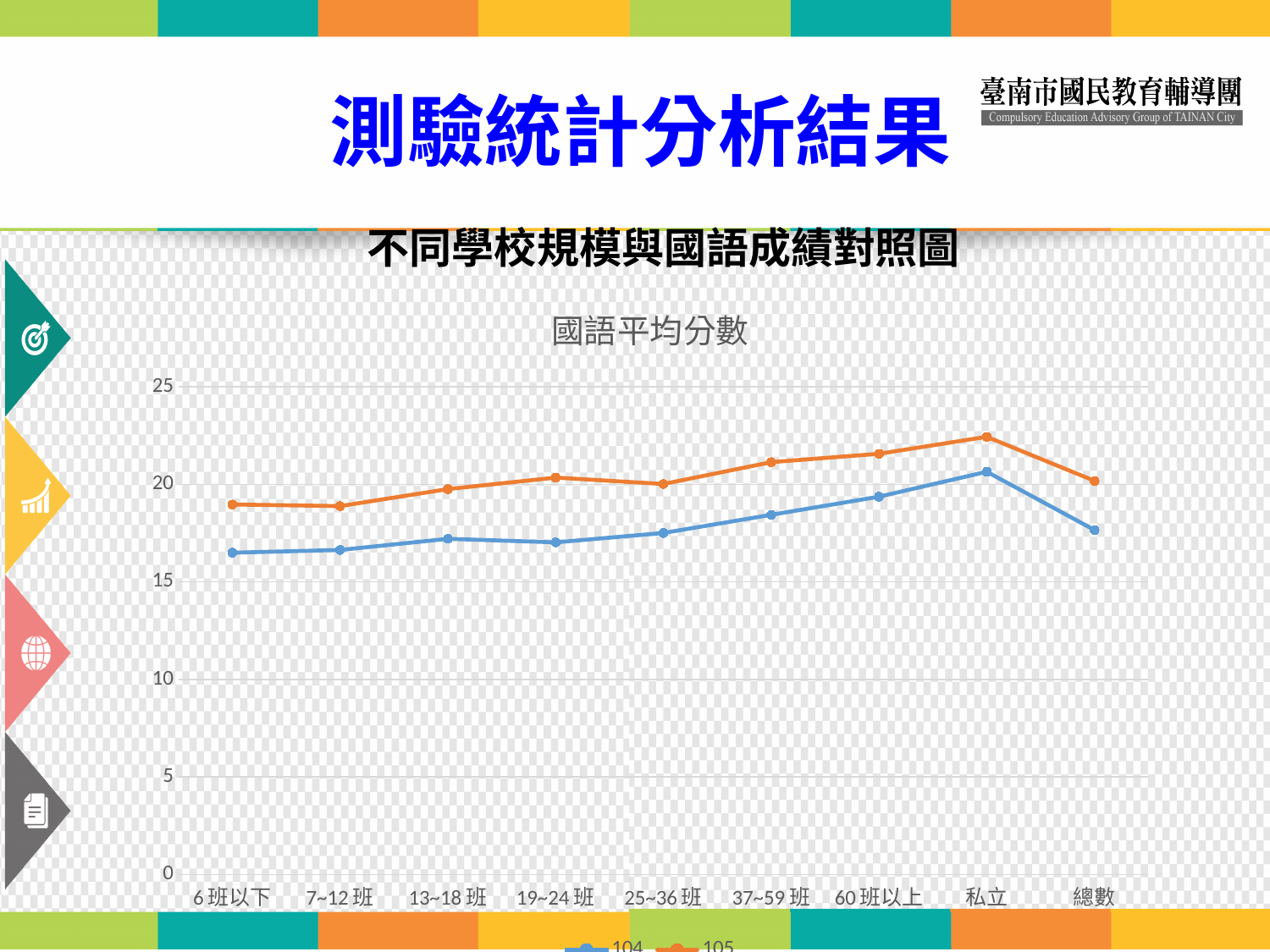
What kind of chart is shown on the slide? line chart What is the title of the chart? 國語平均分數 For the 總數 category, which series has the larger value, 104 or 105? 105 Is the value for 6班以下 in the 104 series greater or less than 20? less Do the values of the 104 series generally rise or fall from 6班以下 to 私立? rise Which category has the highest value for the 104 series? 私立 Is the value for 總數 in the 104 series greater or less than 15? greater Is the value for 私立 in the 105 series greater or less than 20? greater Which category has the lowest value for the 104 series? 6班以下 How many categories are shown on the x axis of the chart? 9 How many series does the chart's legend list? 2 Which category has the highest value for the 105 series? 私立